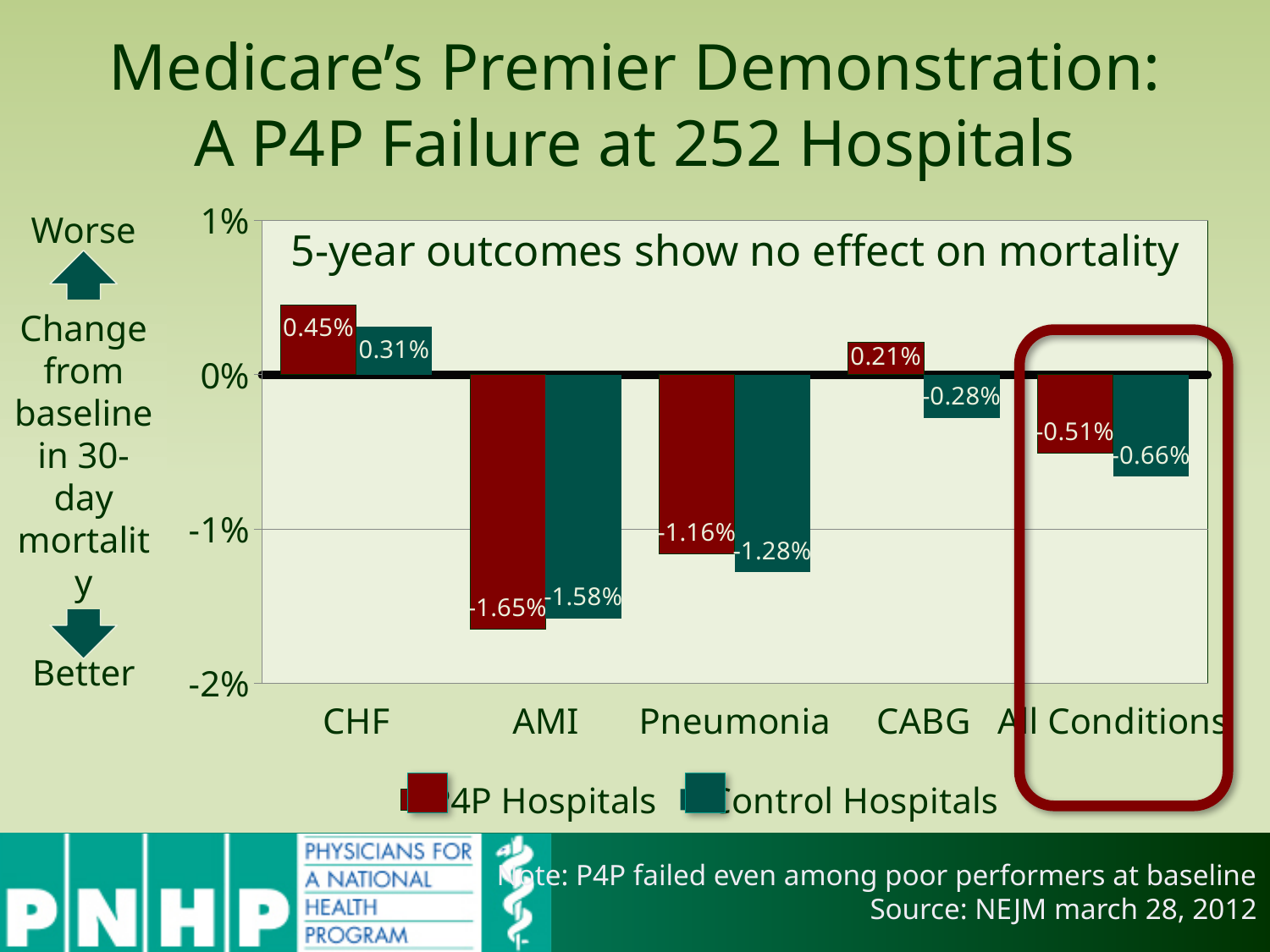
What is the value for P4P Hospitals in the All Conditions category? -0.51% What kind of chart is shown on the slide? Bar chart In the CABG category, which is larger: the P4P Hospitals value or the Control Hospitals value? P4P Hospitals What is the difference between the P4P Hospitals and Control Hospitals values in the Pneumonia category? 0.12% Which category has the lowest value for P4P Hospitals? AMI Is the value for Control Hospitals in the Pneumonia category greater or less than -1%? less What is the value for P4P Hospitals in the CHF category? 0.45% What is the value for Control Hospitals in the AMI category? -1.58% Which category has the highest value for Control Hospitals? CHF How many categories are shown on the x axis? 5 What is the value for Control Hospitals in the CABG category? -0.28% How many series does the legend list? 2